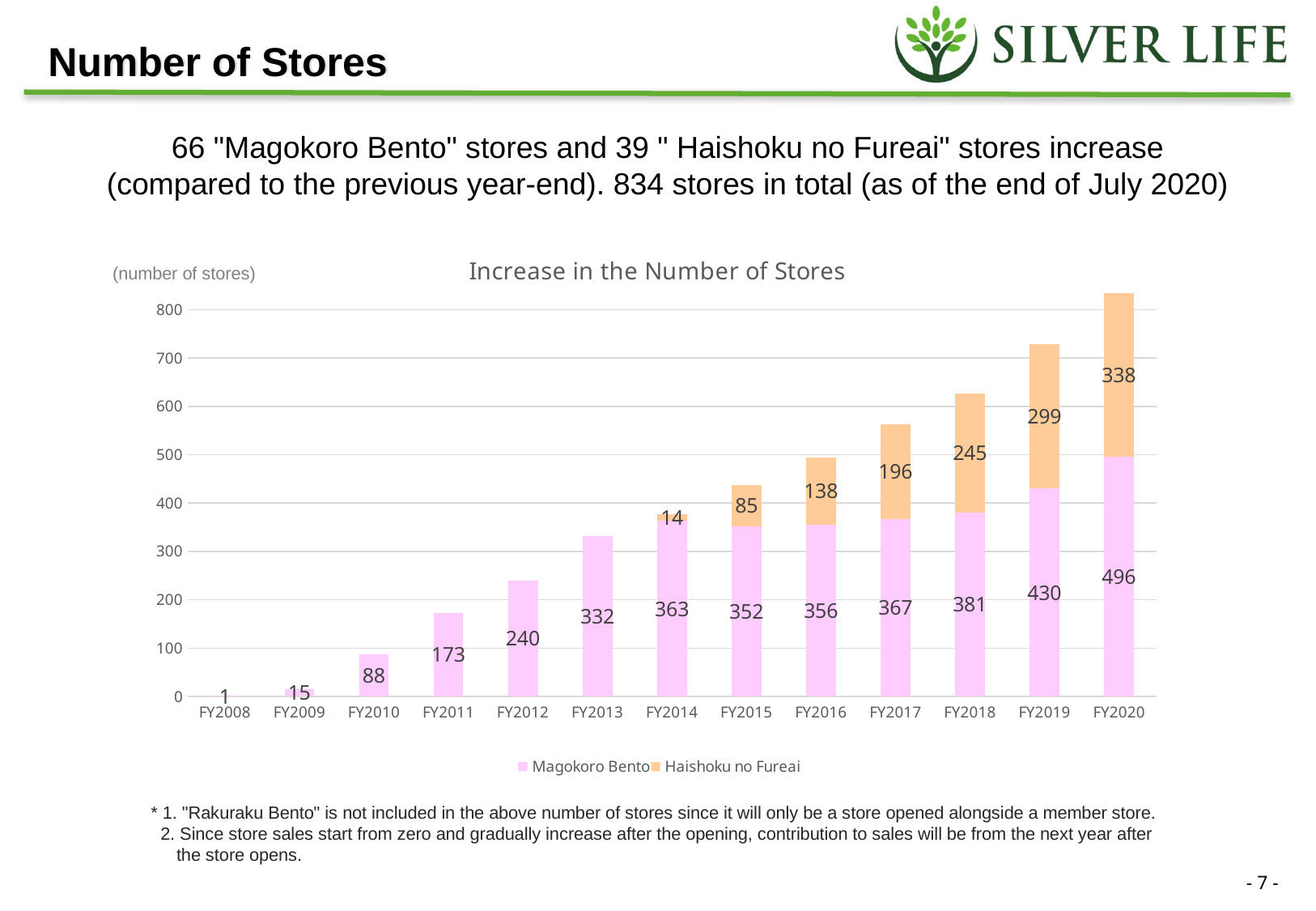
How many series does the chart legend list? 2 What is the number of Magokoro Bento stores in FY2020? 496 In which fiscal year is the number of Magokoro Bento stores the lowest? FY2008 What is the title of the chart? Increase in the Number of Stores How many fiscal years are shown on the x axis of the chart? 13 What is the total number of stores in FY2020 (Magokoro Bento plus Haishoku no Fureai)? 834 What is the difference between the number of Magokoro Bento stores in FY2020 and FY2019? 66 Which is larger: the number of Magokoro Bento stores in FY2014 or in FY2015? FY2014 What is the number of Magokoro Bento stores in FY2012? 240 What type of chart is shown on the slide? Stacked bar chart In which fiscal year is the number of Haishoku no Fureai stores the highest? FY2020 What is the number of Haishoku no Fureai stores in FY2017? 196